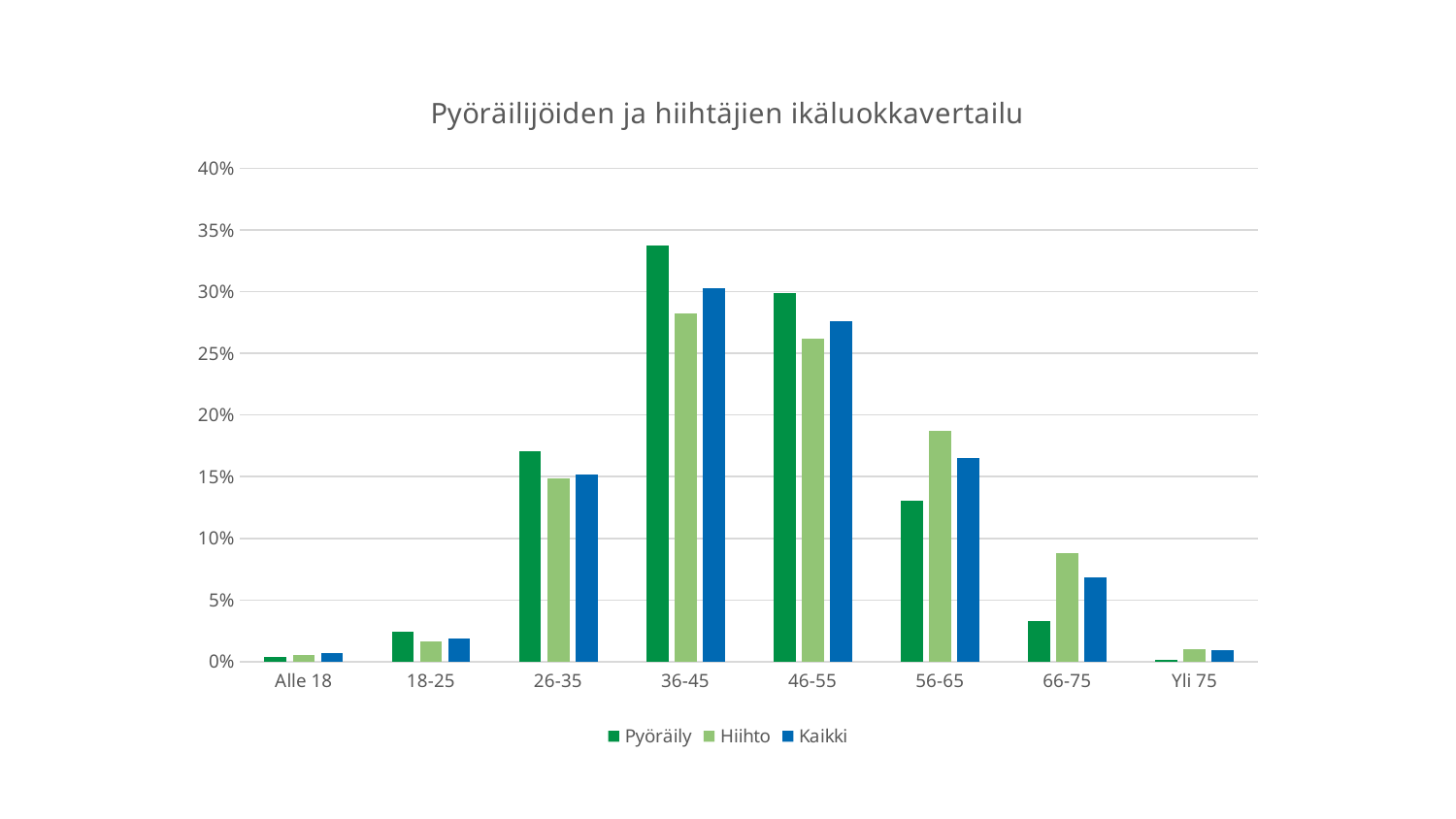
Is the value for Kaikki in the 46-55 category greater or less than 25%? greater How many age categories are shown on the x axis? 8 Is the value for Pyöräily in the 36-45 category greater or less than 30%? greater Which age category has the highest value for Hiihto? 36-45 In the 36-45 category, which is larger: Pyöräily or Kaikki? Pyöräily Do the Pyöräily values rise or fall from the 36-45 category to the Yli 75 category? fall Is the value for Pyöräily in the 66-75 category greater or less than 5%? less In the 56-65 category, which is larger: Pyöräily or Hiihto? Hiihto How many series does the legend list? 3 What kind of chart is shown on the slide? bar chart Which age category has the highest value for Pyöräily? 36-45